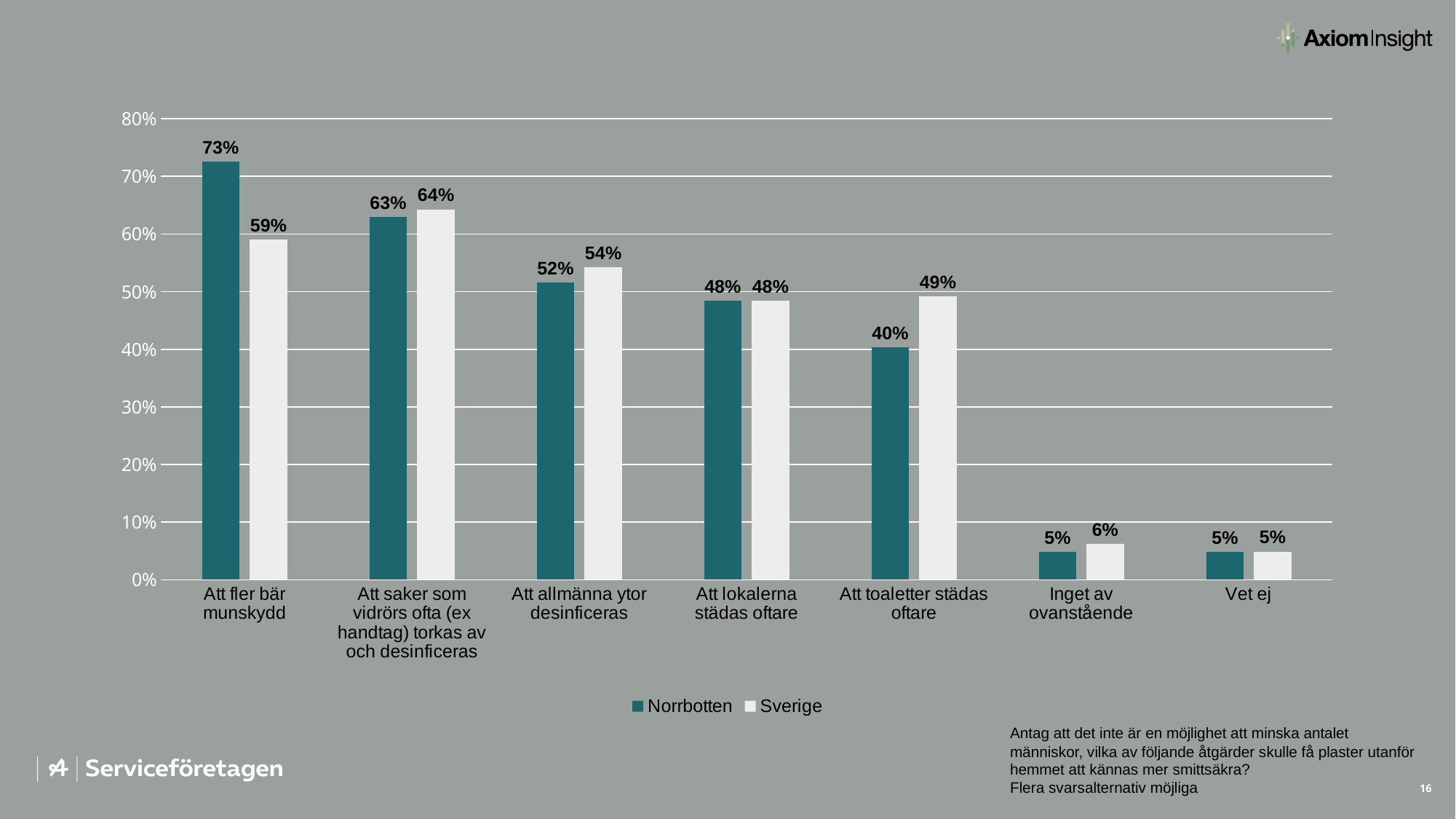
How many categories are shown on the x axis? 7 Which category has the highest Norrbotten value? Att fler bär munskydd What is the difference between the Norrbotten and Sverige values for "Att fler bär munskydd"? 14% Which category has the lowest Sverige value? Vet ej What is the difference between the Sverige and Norrbotten values for "Att toaletter städas oftare"? 9% What kind of chart is shown on the slide? Bar chart How many series does the legend list? 2 What is the Norrbotten value for "Att fler bär munskydd"? 73% Which series is shown in dark teal in the legend? Norrbotten What is the Sverige value for "Att allmänna ytor desinficeras"? 54% For "Att saker som vidrörs ofta (ex handtag) torkas av och desinficeras", which series has the larger value, Norrbotten or Sverige? Sverige What is the Sverige value for "Att toaletter städas oftare"? 49%